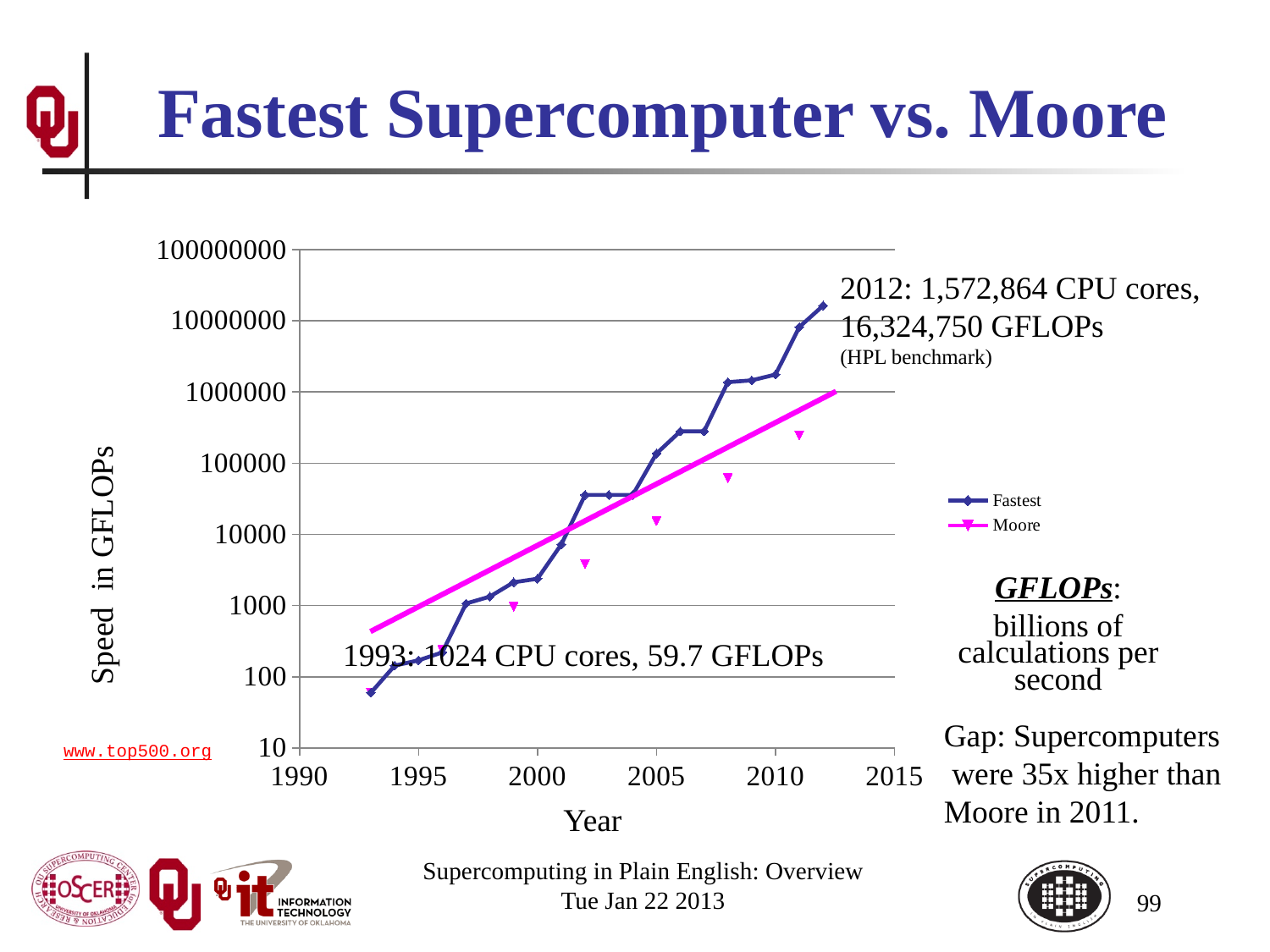
Does the Fastest series rise or fall as the year increases? rise According to the annotation, what was the speed of the fastest supercomputer in 2012? 16,324,750 GFLOPs Is the Fastest value for 1993 greater or less than 100? less According to the annotation, what was the speed of the fastest supercomputer in 1993? 59.7 GFLOPs What is the label of the y axis? Speed in GFLOPs In 2011, which series has the higher value, Fastest or Moore? Fastest Is the Moore value for 2005 greater or less than 100000? less How many series does the legend list? 2 How many CPU cores did the fastest supercomputer have in 2012, according to the annotation? 1,572,864 Is the Fastest value for 2012 greater or less than 10000000? greater What are the two series named in the legend? Fastest and Moore What kind of chart is shown on the slide? line chart